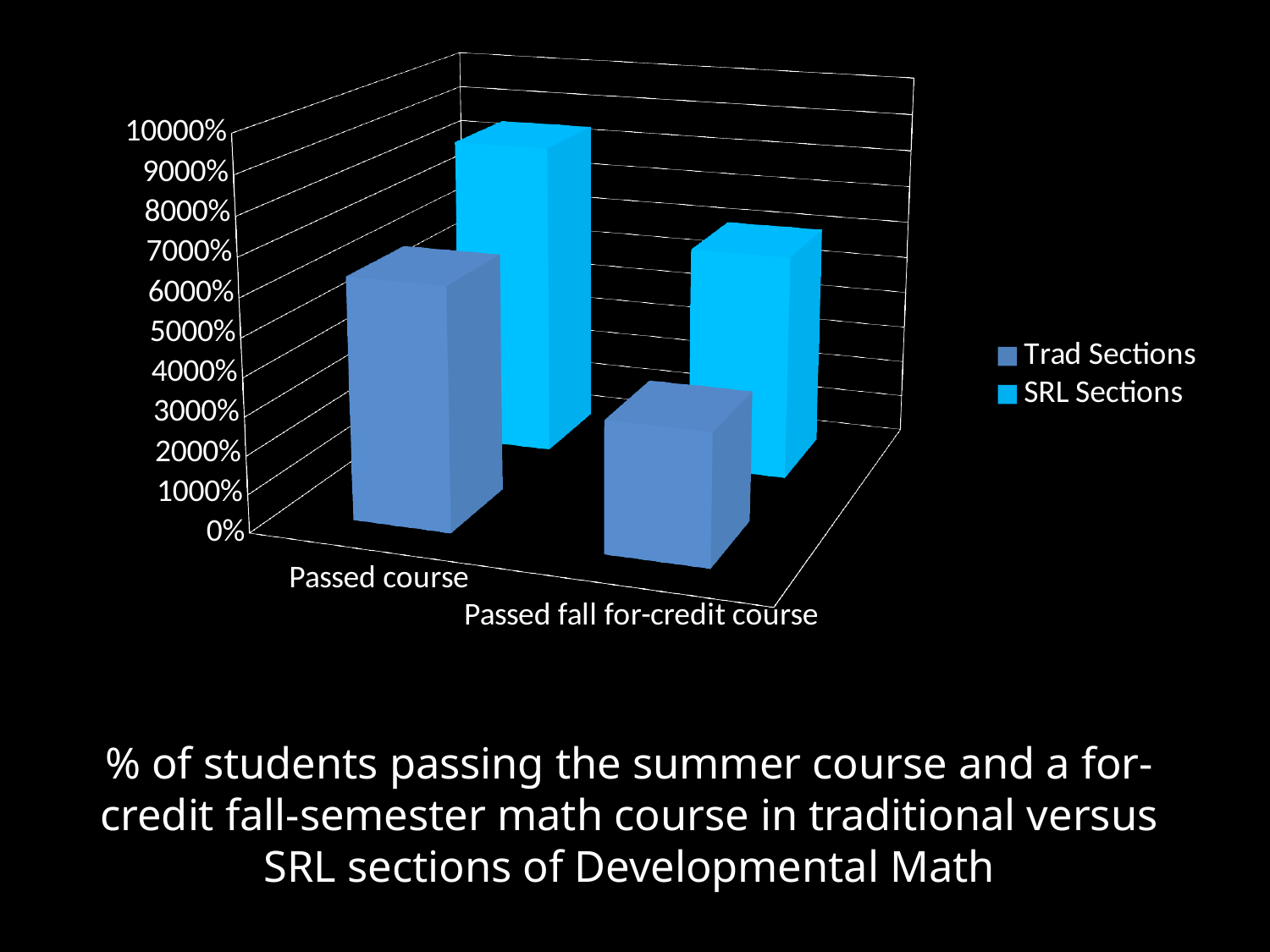
How many categories are shown on the x axis? 2 Which series has the highest bar for the 'Passed course' category? SRL Sections Which bar is the shortest in the whole chart? Trad Sections, Passed fall for-credit course What kind of chart is shown on the slide? Bar chart Which bar is the tallest in the whole chart? SRL Sections, Passed course What are the two entries listed in the legend? Trad Sections and SRL Sections Is the Trad Sections value for 'Passed course' greater or less than 5000%? greater Which series has the lowest bar for the 'Passed fall for-credit course' category? Trad Sections For 'Passed fall for-credit course', is the SRL Sections value larger or smaller than the Trad Sections value? Larger Do the Trad Sections values rise or fall from 'Passed course' to 'Passed fall for-credit course'? Fall How many series does the legend list? 2 Is the SRL Sections value for 'Passed course' greater or less than 8000%? greater